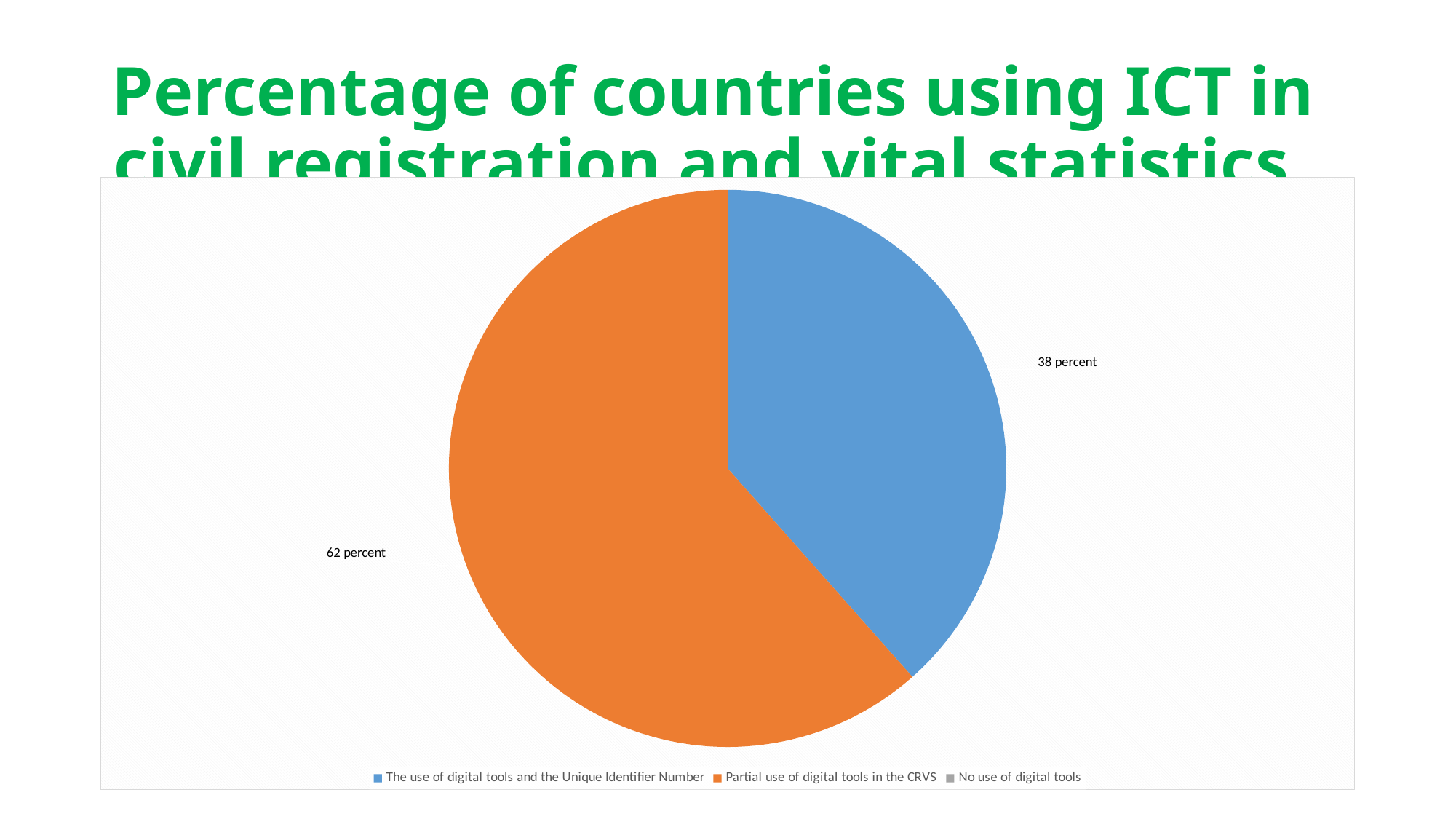
What share of the pie is labelled for 'Partial use of digital tools in the CRVS'? 62 percent By how many percentage points does the 'Partial use of digital tools in the CRVS' slice exceed the 'The use of digital tools and the Unique Identifier Number' slice? 24 percent What do the two labelled slices add up to? 100 percent How many categories does the legend list? 3 How many slices are visible in the pie? 2 Which category has the largest slice of the pie? Partial use of digital tools in the CRVS What type of chart is shown on the slide? Pie chart What is the title of the slide containing the chart? Percentage of countries using ICT in civil registration and vital statistics Which is larger: the slice for 'Partial use of digital tools in the CRVS' or the slice for 'The use of digital tools and the Unique Identifier Number'? Partial use of digital tools in the CRVS What colour is the slice for 'Partial use of digital tools in the CRVS'? Orange Which of the two visible slices is the smaller one? The use of digital tools and the Unique Identifier Number What share of the pie is labelled for 'The use of digital tools and the Unique Identifier Number'? 38 percent